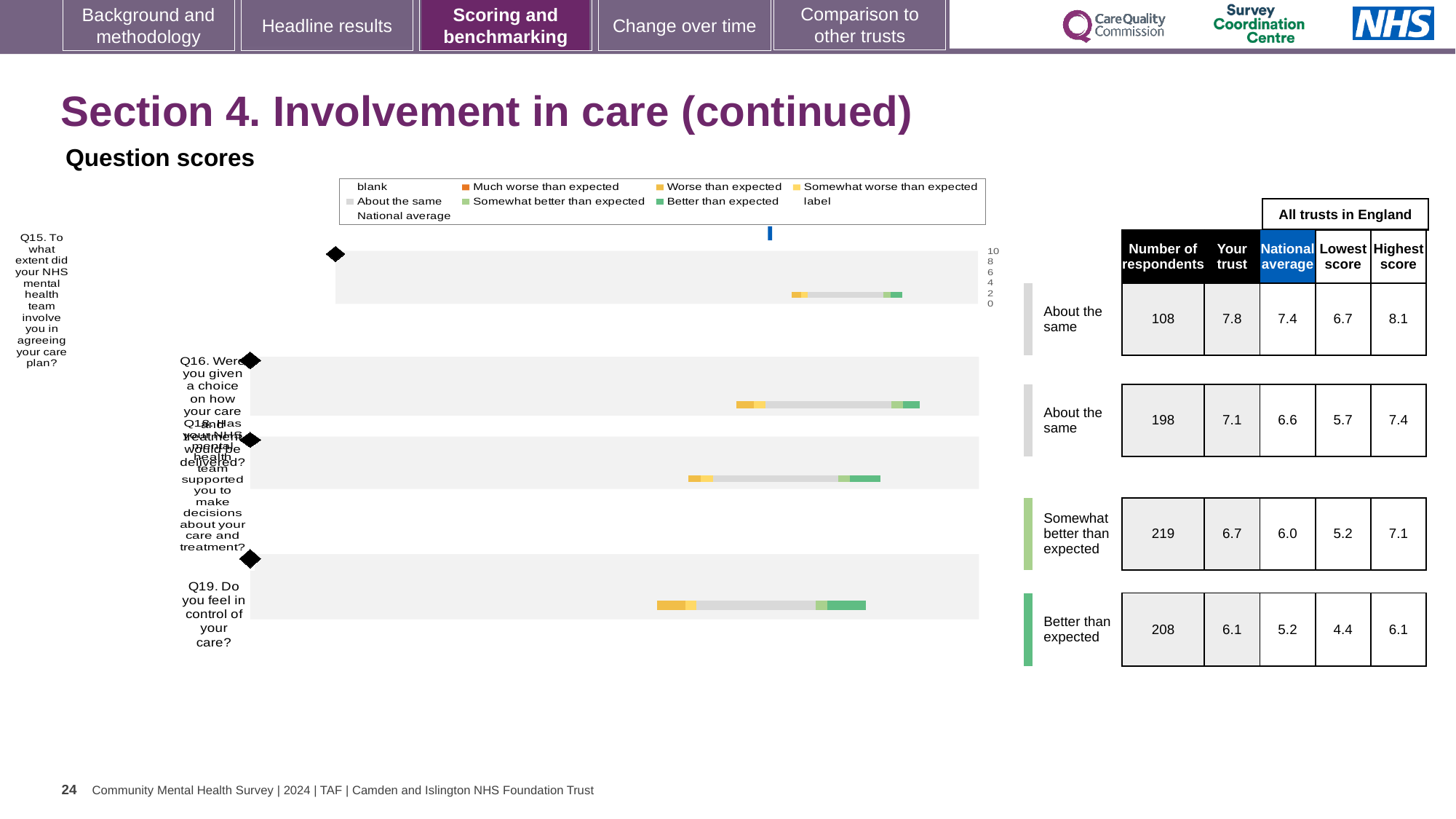
What is the national average score for Q19 (feeling in control of your care)? 5.2 For Q16, how much higher is the 'Your trust' score than the national average? 0.5 What benchmark category is shown for Q19? Better than expected For Q18, which is larger: the 'Your trust' score or the national average? Your trust What kind of chart is used to show the question scores on this slide? bar chart For Q15, what is the difference between the highest score and the lowest score among all trusts in England? 1.4 What is the highest score among all trusts in England for Q16? 7.4 What is the 'Your trust' score for Q15 (involving you in agreeing your care plan)? 7.8 Which question has the lowest national average score? Q19 Which question has the highest 'Your trust' score? Q15 How many respondents answered Q18 (supported to make decisions about care and treatment)? 219 How many questions (rows) are plotted in the question scores chart? 4